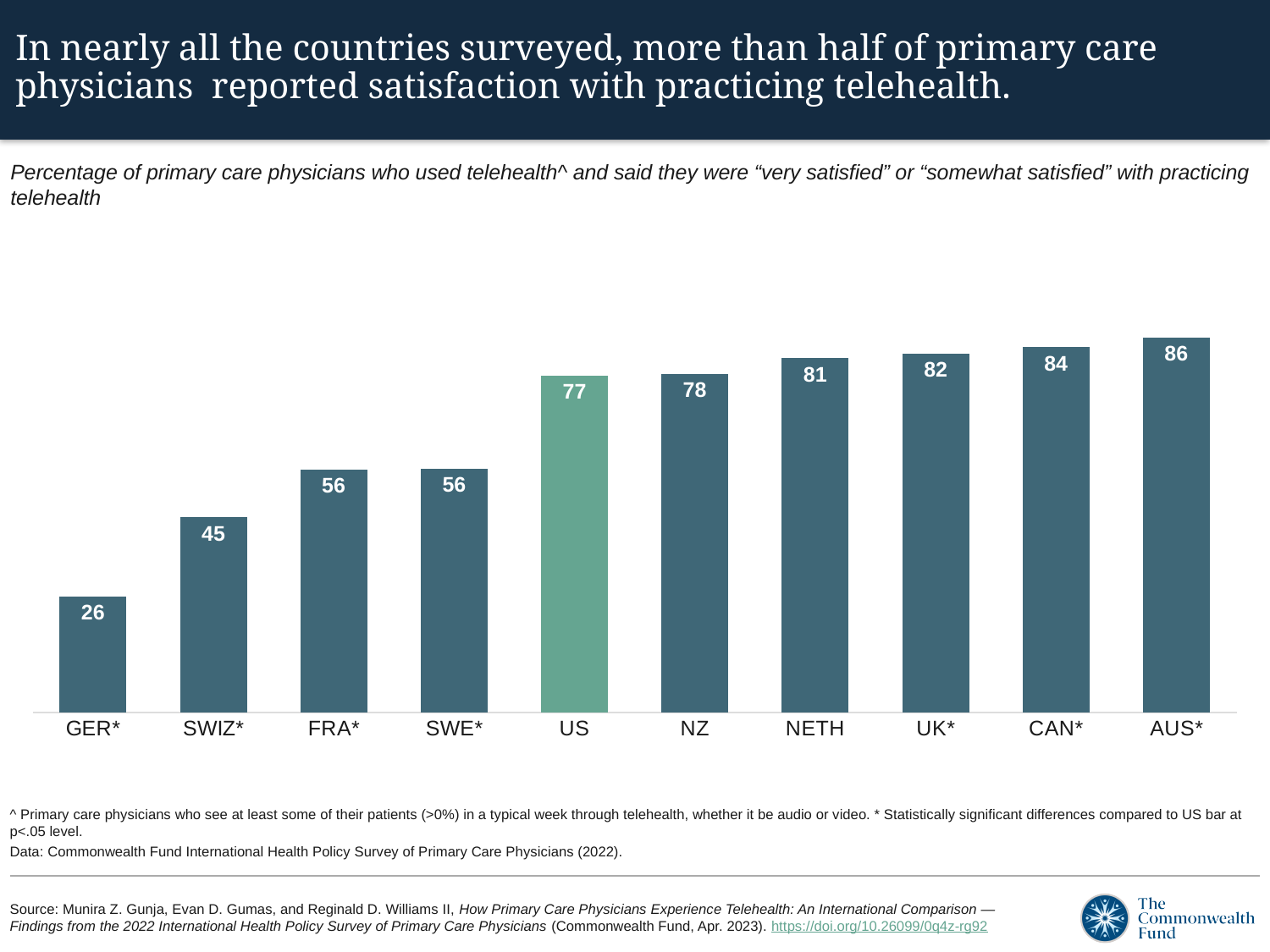
Which is larger, the value for SWIZ* or the value for NZ? NZ What is the difference between the values for AUS* and GER*? 60 What is the value for GER*? 26 Which country has the lowest value? GER* Do the values rise or fall from left to right along the x axis? rise Which country has the highest value? AUS* What is the difference between the values for CAN* and US? 7 What is the value for the US? 77 Which bar is shown in a different colour from the others? US How many countries are shown in the chart? 10 What is the value for NETH? 81 What kind of chart is shown on the slide? bar chart